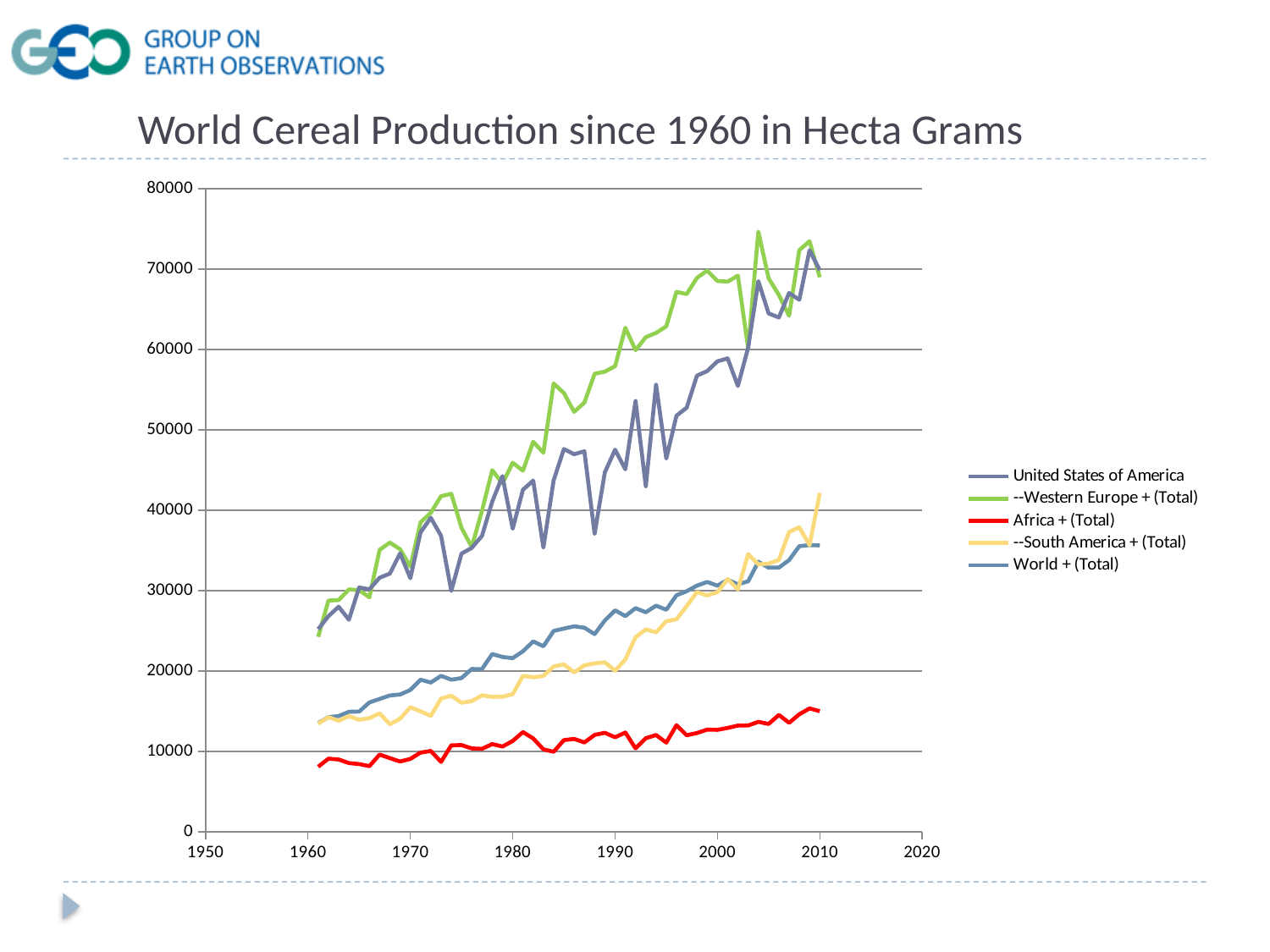
What is the title of the chart? World Cereal Production since 1960 in Hecta Grams In 1985, which is larger: --Western Europe + (Total) or United States of America? --Western Europe + (Total) What kind of chart is shown on the slide? line chart Is the value for World + (Total) in 1960 greater or less than 20000? less Is the value for Africa + (Total) in 2010 greater or less than 20000? less How many series does the legend list? 5 In 1990, which is larger: World + (Total) or --South America + (Total)? World + (Total) Do the values for Africa + (Total) rise or fall from 1960 to 2010? rise Do the values for World + (Total) rise or fall along the x axis? rise Which series has the lowest values across the whole period? Africa + (Total) Is the value for --Western Europe + (Total) in 2000 greater or less than 60000? greater Which series reaches the highest value anywhere on the chart? --Western Europe + (Total)